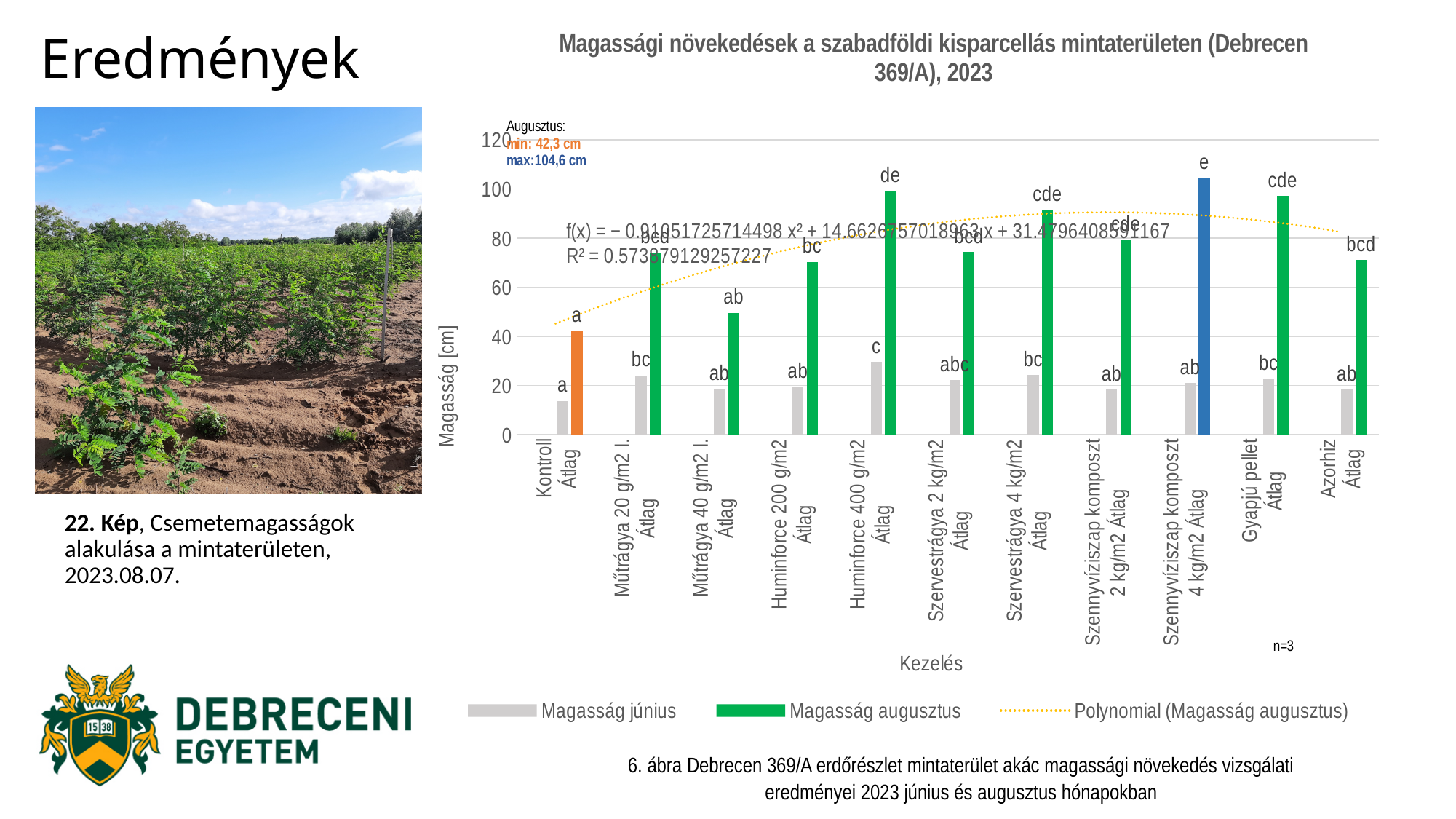
Which treatment has the highest Magasság június value? Huminforce 400 g/m2 What is the label of the y axis? Magasság [cm] According to the annotation, what is the maximum August height? 104,6 cm According to the annotation, what is the minimum August height? 42,3 cm Is the Magasság augusztus value for Huminforce 400 g/m2 greater or less than 80? greater How many treatment categories (Kezelés) are shown on the x axis? 11 How many series does the chart legend list? 3 Is the Magasság augusztus value for Műtrágya 40 g/m2 I. greater or less than 60? less What kind of chart is shown on the slide? Bar chart Which treatment has the highest Magasság augusztus value? Szennyvíziszap komposzt 4 kg/m2 Which is larger: the Magasság augusztus value for Huminforce 400 g/m2 or for Szervestrágya 2 kg/m2? Huminforce 400 g/m2 Which treatment has the lowest Magasság augusztus value? Kontroll